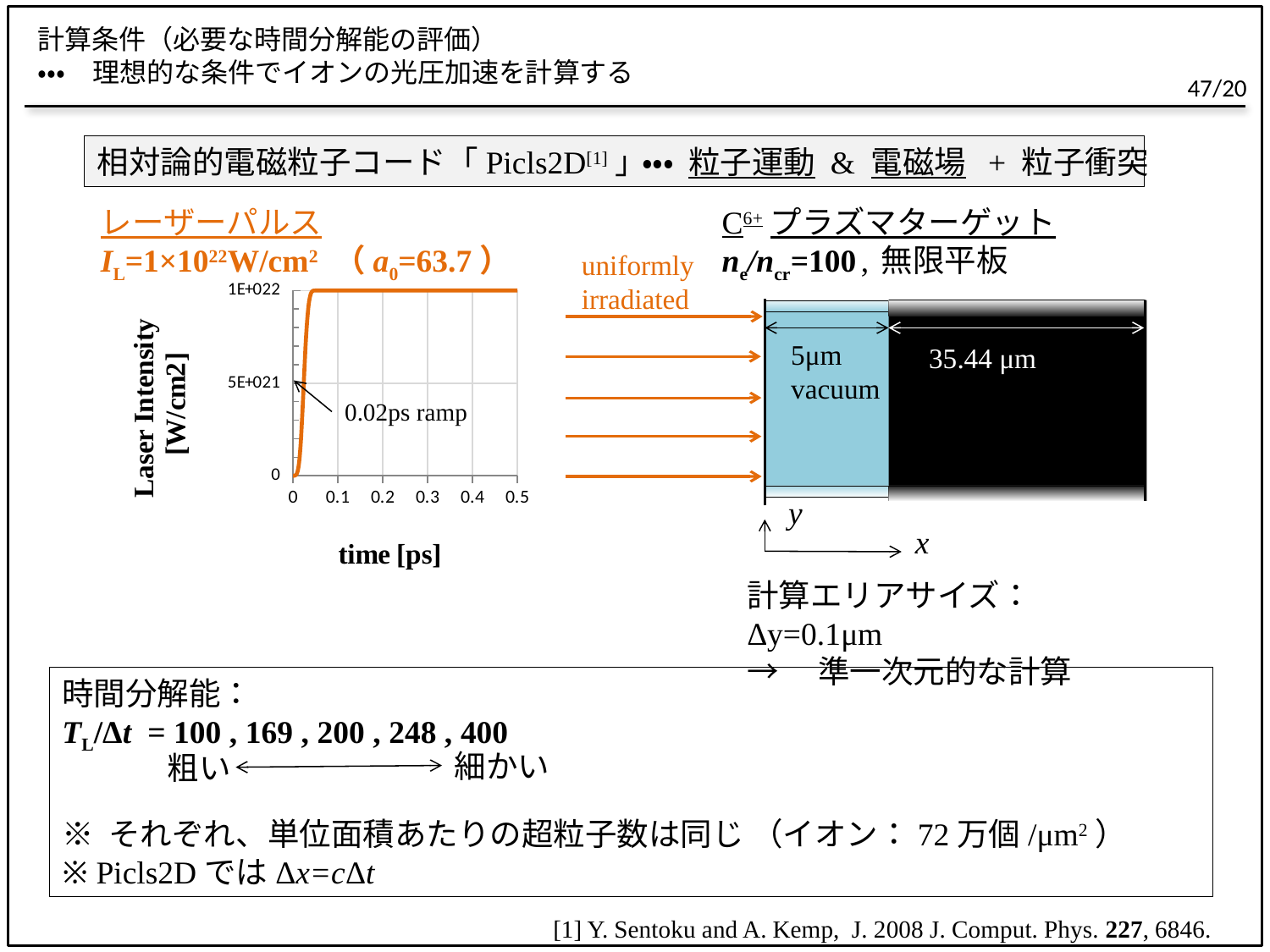
What ramp duration is annotated on the Laser Intensity chart? 0.02ps ramp What kind of chart is the Laser Intensity plot on the slide? line chart What is the largest time value labelled on the x axis of the Laser Intensity chart? 0.5 In the Laser Intensity chart, does the laser intensity rise, fall, or stay flat between 0.1 ps and 0.5 ps? stay flat How many tick labels are shown on the x axis of the Laser Intensity chart? 6 In the Laser Intensity chart, is the laser intensity at time 0.3 ps greater or less than 5E+021? greater What is the label of the y axis of the Laser Intensity chart? Laser Intensity [W/cm2] What is the highest tick value shown on the y axis of the Laser Intensity chart? 1E+022 What is the label of the x axis of the Laser Intensity chart? time [ps] In the Laser Intensity chart, what value does the curve plateau at after the initial ramp? 1E+022 In the Laser Intensity chart, does the laser intensity rise or fall at the very start of the time axis? rise